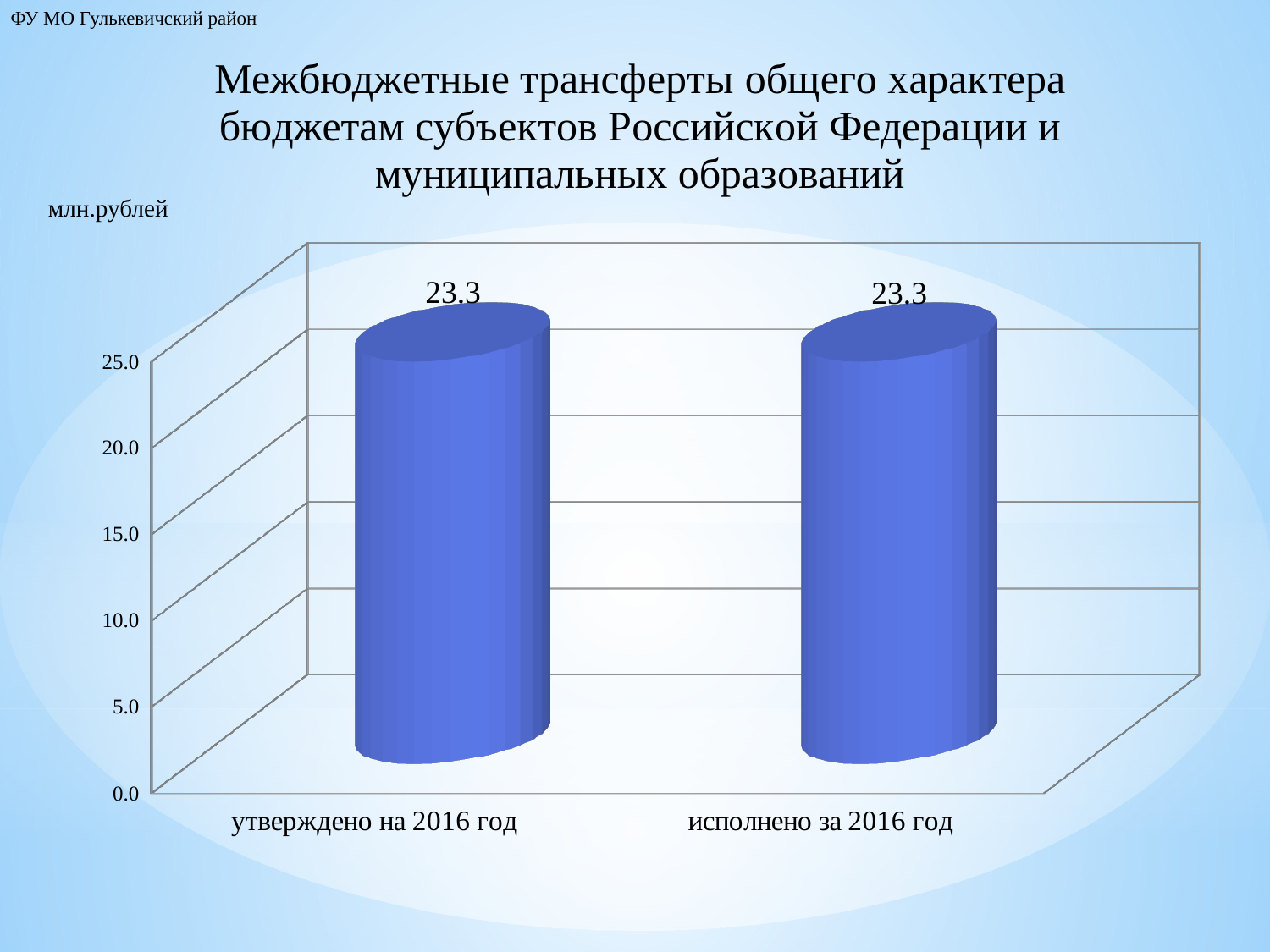
Is the value for "исполнено за 2016 год" larger than, smaller than, or equal to the value for "утверждено на 2016 год"? Equal How many categories are plotted on the chart? 2 What is the highest value shown on the vertical axis? 25.0 Do the values rise, fall, or stay the same from "утверждено на 2016 год" to "исполнено за 2016 год"? Stay the same What unit of measurement is indicated above the chart? млн.рублей What is the difference between the value for "утверждено на 2016 год" and the value for "исполнено за 2016 год"? 0.0 What is the value for "утверждено на 2016 год"? 23.3 Is the value for "исполнено за 2016 год" greater or less than 25.0? less What is the value for "исполнено за 2016 год"? 23.3 What kind of chart is shown on the slide? Bar chart Is the value for "утверждено на 2016 год" greater or less than 20.0? greater